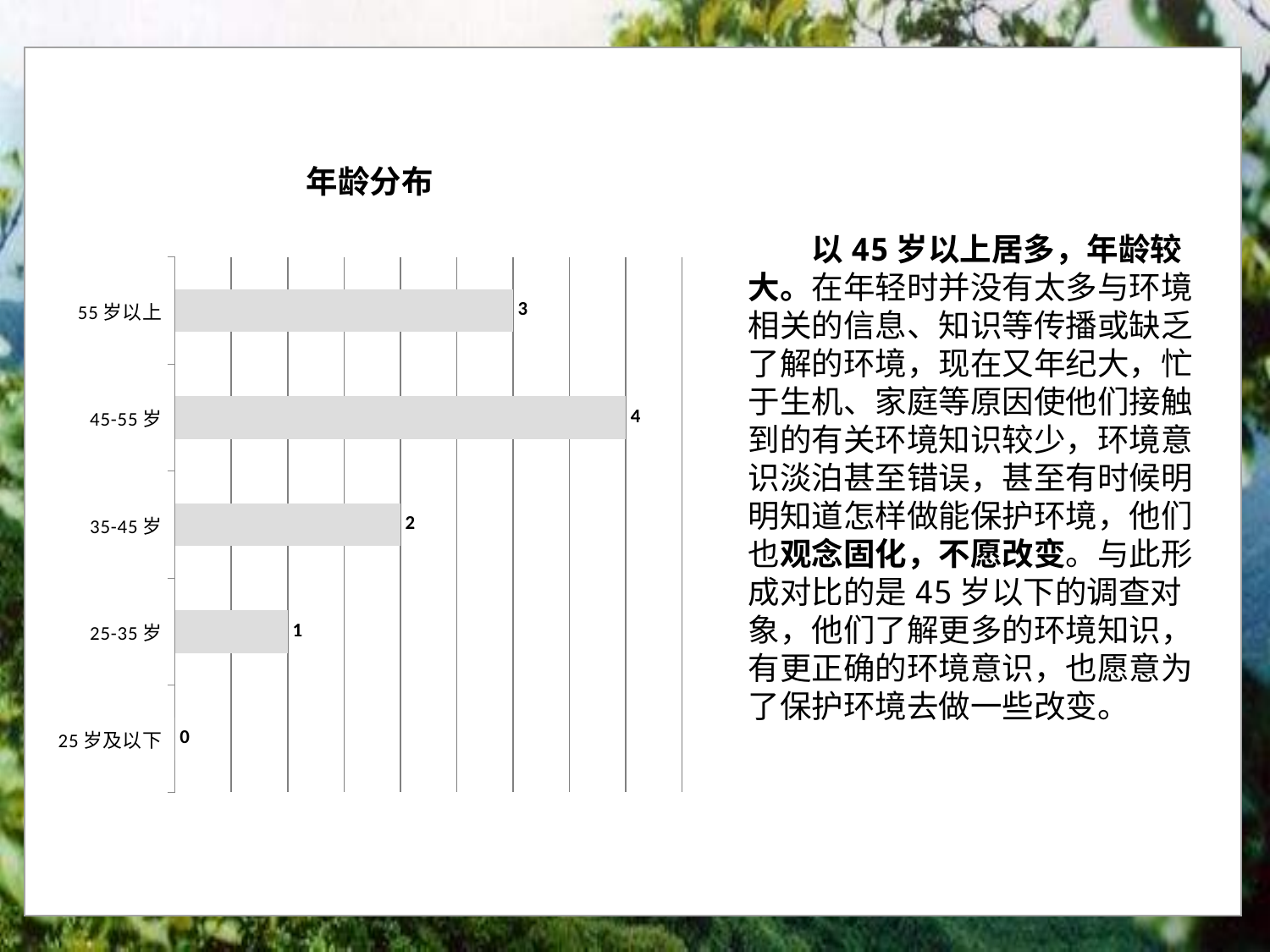
Which age group has the lowest value in the 年龄分布 chart? 25 岁及以下 What is the value for 25-35 岁 in the 年龄分布 chart? 1 What is the value for 25 岁及以下 in the 年龄分布 chart? 0 What is the difference between the values for 45-55 岁 and 35-45 岁? 2 What kind of chart is the 年龄分布 chart? bar chart What is the title of the chart on the slide? 年龄分布 What is the value for 55 岁以上 in the 年龄分布 chart? 3 What is the value for 45-55 岁 in the 年龄分布 chart? 4 Which is larger, the value for 55 岁以上 or the value for 35-45 岁? 55 岁以上 Which age group has the highest value in the 年龄分布 chart? 45-55 岁 How many age categories are shown in the 年龄分布 chart? 5 What is the total of all values shown in the 年龄分布 chart? 10